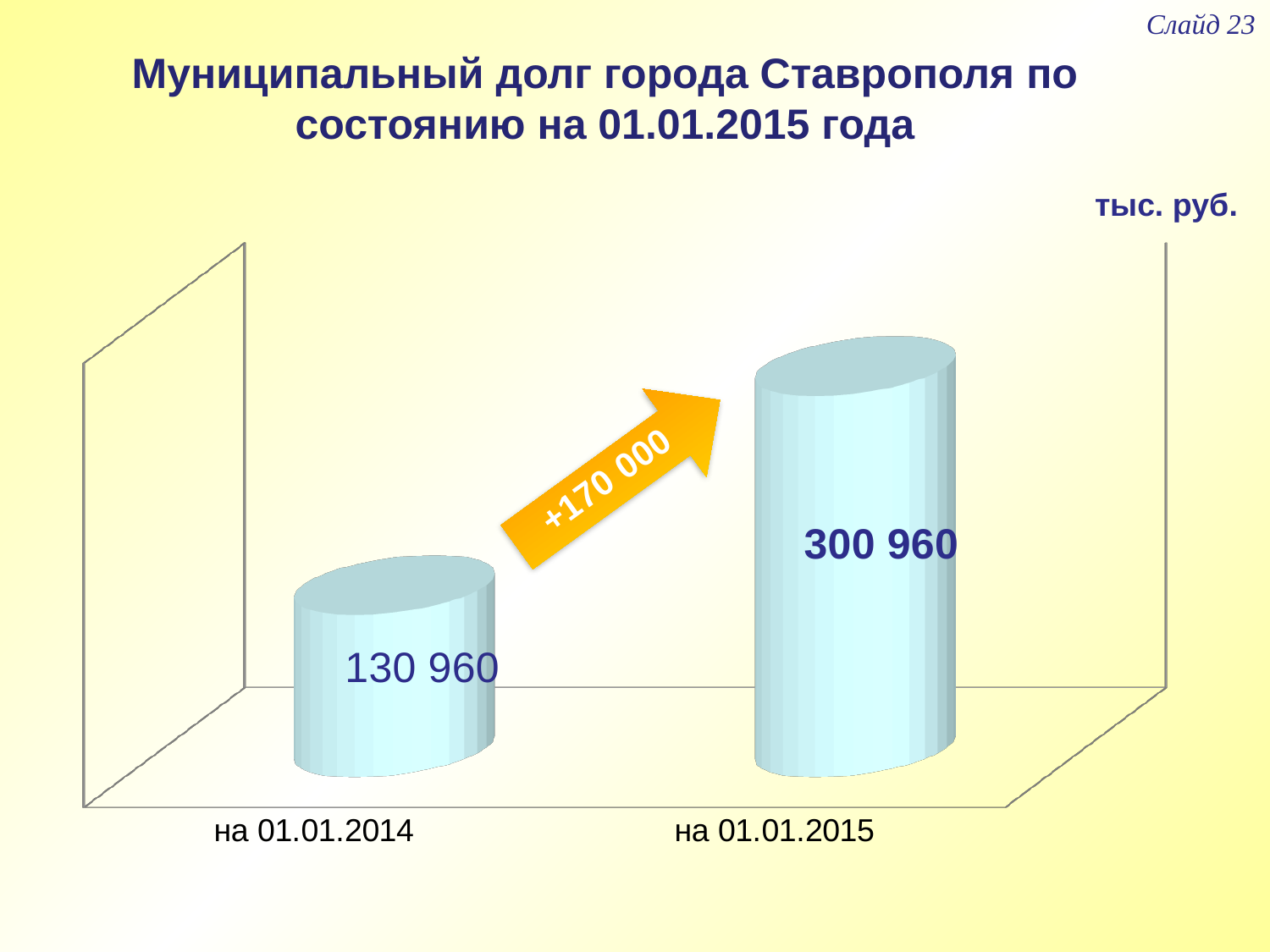
Do the values rise or fall from 01.01.2014 to 01.01.2015? rise Which date has the lower municipal debt value? на 01.01.2014 What kind of chart is shown on the slide? bar chart How many categories (dates) are plotted on the chart? 2 Is the value for на 01.01.2014 larger or smaller than the value for на 01.01.2015? smaller What unit is indicated for the values on the chart? тыс. руб. What change is written on the arrow between the two bars? +170 000 Which date has the higher municipal debt value? на 01.01.2015 What is the difference between the debt on 01.01.2015 and the debt on 01.01.2014? 170 000 What is the municipal debt value shown for на 01.01.2014? 130 960 What is the municipal debt value shown for на 01.01.2015? 300 960